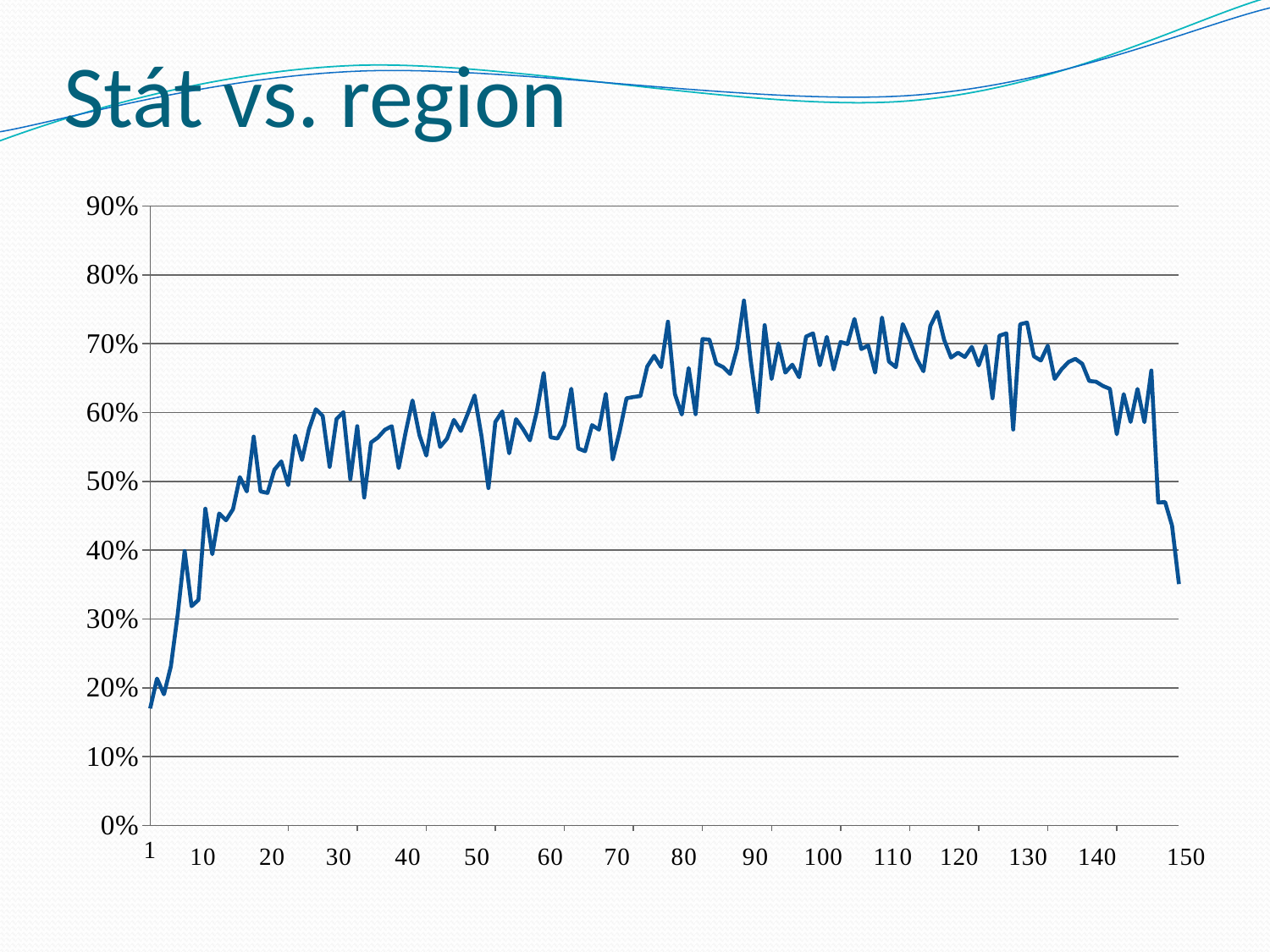
What is the title of the chart? Stát vs. region Is the lowest point on the line greater or less than 20%? less Is the value at x = 100 greater or less than 60%? greater What kind of chart is shown on the slide? line chart What is the highest value labelled on the y axis? 90% Is the value at x = 1 greater or less than 20%? less Which is larger, the value at x = 1 or the value at x = 100? x = 100 Do the values rise or fall between x = 145 and x = 150? fall Do the values generally rise or fall between x = 1 and x = 30? rise